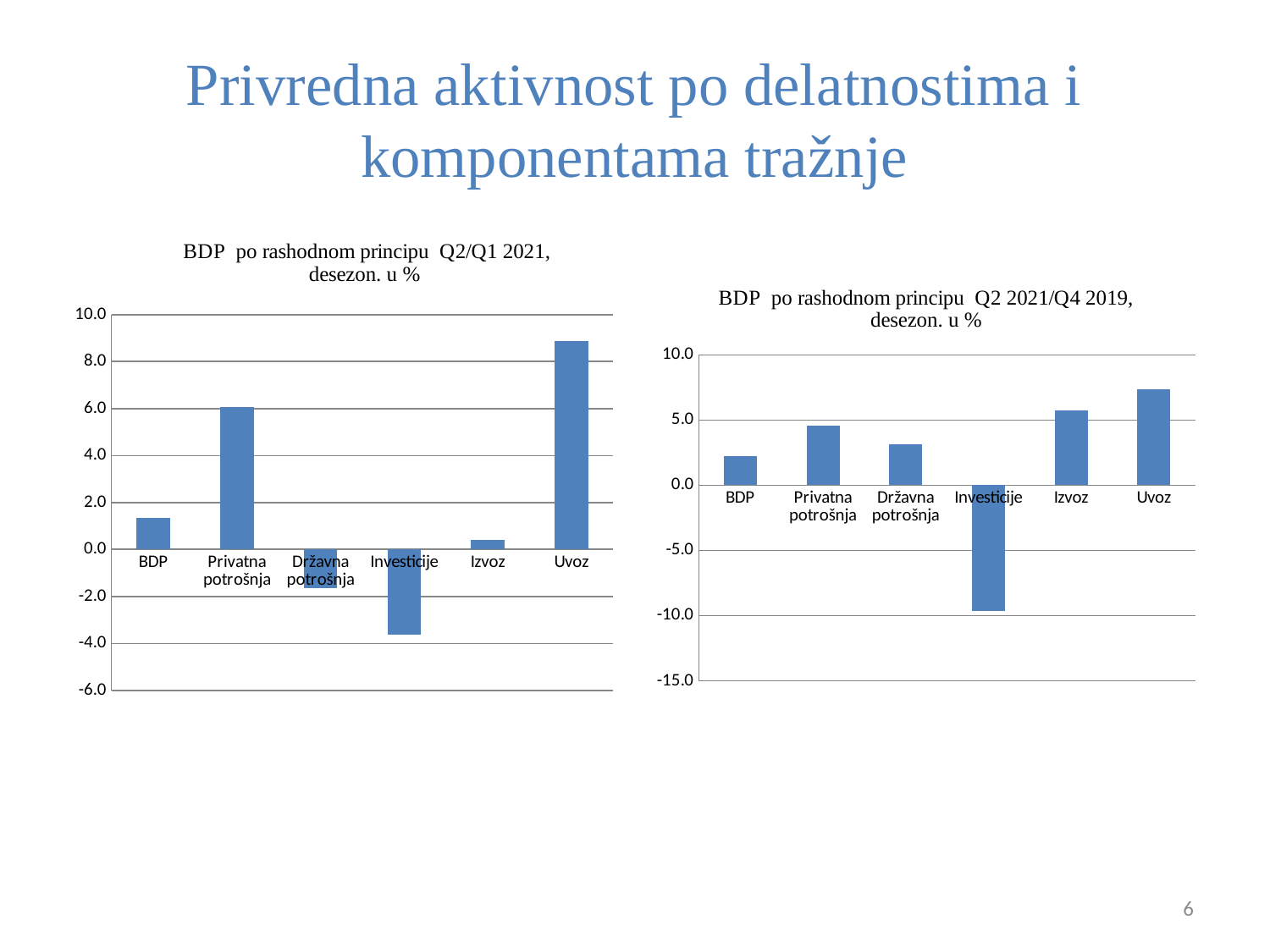
In the chart titled "BDP po rashodnom principu Q2 2021/Q4 2019, desezon. u %", which is larger, the value for Izvoz or the value for Privatna potrošnja? Izvoz In the chart titled "BDP po rashodnom principu Q2/Q1 2021, desezon. u %", which is larger, the value for Privatna potrošnja or the value for BDP? Privatna potrošnja In the chart titled "BDP po rashodnom principu Q2/Q1 2021, desezon. u %", which category has the lowest value? Investicije In the chart titled "BDP po rashodnom principu Q2 2021/Q4 2019, desezon. u %", which category has the highest value? Uvoz In the chart titled "BDP po rashodnom principu Q2 2021/Q4 2019, desezon. u %", is the value for Investicije greater or less than -5.0? less In the chart titled "BDP po rashodnom principu Q2/Q1 2021, desezon. u %", which category has the highest value? Uvoz In the chart titled "BDP po rashodnom principu Q2 2021/Q4 2019, desezon. u %", is the value for Uvoz greater or less than 5.0? greater In the chart titled "BDP po rashodnom principu Q2/Q1 2021, desezon. u %", is the value for Privatna potrošnja greater or less than 4.0? greater What kind of chart is the chart on the left of the slide? bar chart In the chart titled "BDP po rashodnom principu Q2 2021/Q4 2019, desezon. u %", which category has the lowest value? Investicije How many categories are shown in the chart titled "BDP po rashodnom principu Q2/Q1 2021, desezon. u %"? 6